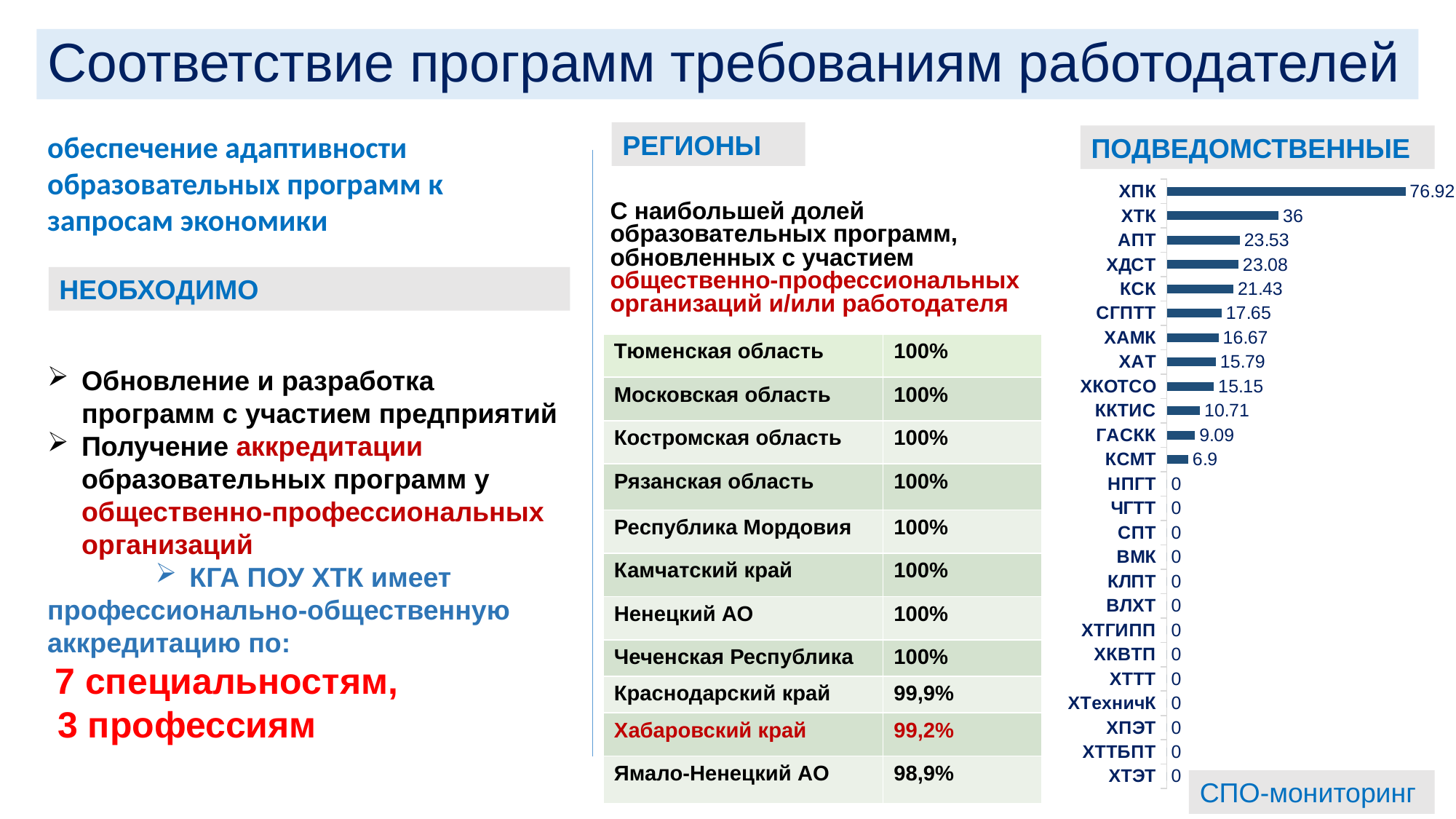
In the ПОДВЕДОМСТВЕННЫЕ chart, what is the value for ХПК? 76.92 In the ПОДВЕДОМСТВЕННЫЕ chart, what is the difference between the values for ХПК and ХТК? 40.92 In the ПОДВЕДОМСТВЕННЫЕ chart, which has a larger value, СГПТТ or ХАТ? СГПТТ How many categories are listed in the ПОДВЕДОМСТВЕННЫЕ chart? 25 In the ПОДВЕДОМСТВЕННЫЕ chart, which category has the highest value? ХПК In the ПОДВЕДОМСТВЕННЫЕ chart, do the values increase or decrease going from the top category to the bottom? decrease What type of chart is shown under the heading ПОДВЕДОМСТВЕННЫЕ? bar chart In the ПОДВЕДОМСТВЕННЫЕ chart, how many categories have a value of 0? 13 In the ПОДВЕДОМСТВЕННЫЕ chart, what is the value for ХТК? 36 In the ПОДВЕДОМСТВЕННЫЕ chart, what is the value for КСМТ? 6.9 In the ПОДВЕДОМСТВЕННЫЕ chart, what is the value for ХКОТСО? 15.15 In the ПОДВЕДОМСТВЕННЫЕ chart, what is the difference between the values for АПТ and ХДСТ? 0.45